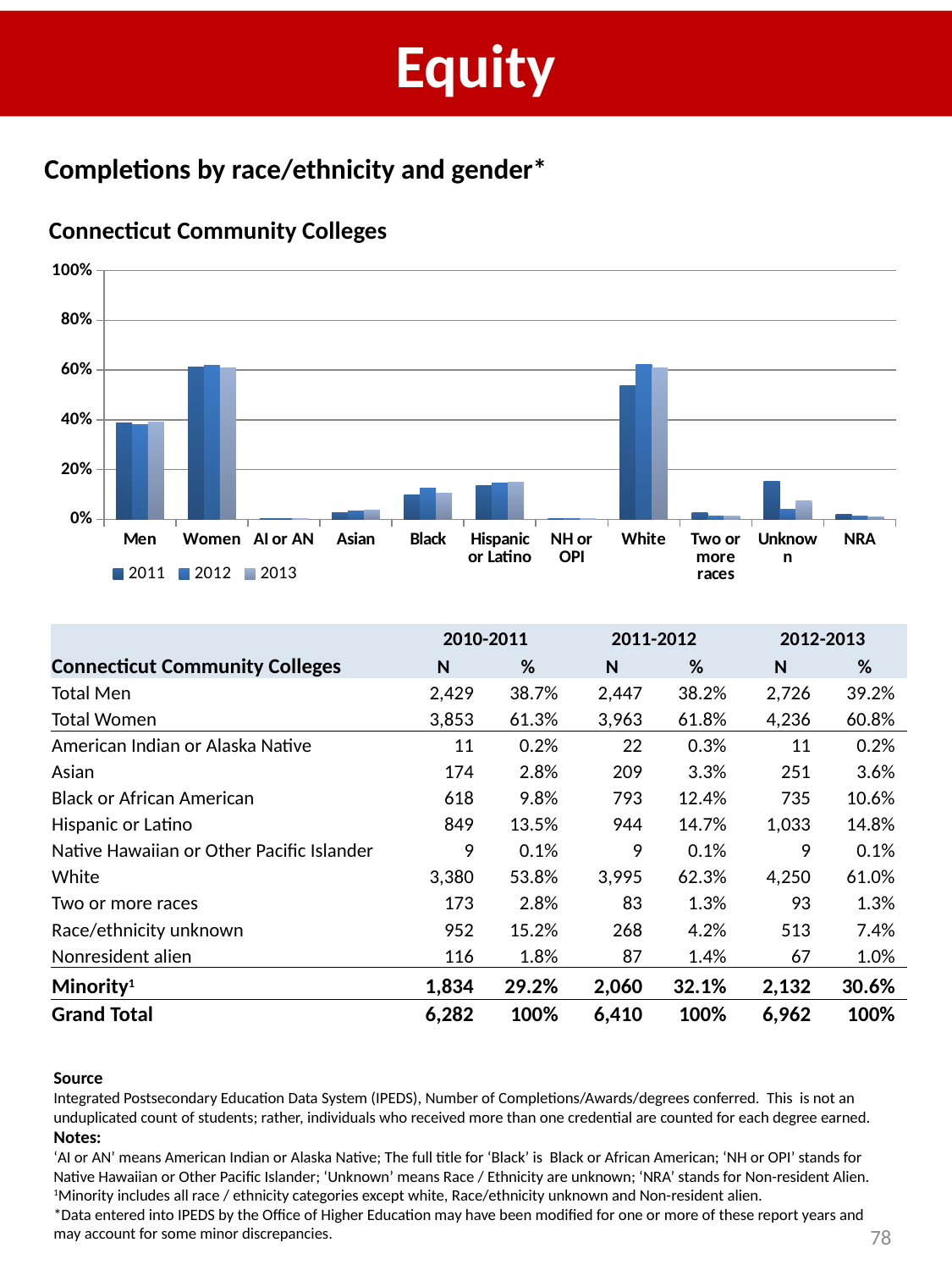
What are the three legend entries of the chart? 2011, 2012, 2013 Which category has the highest bar for 2011? Women Which is larger: the Unknown bar for 2011 or the Unknown bar for 2013? 2011 How many categories are shown along the x axis of the chart? 11 According to the table, what percentage of completions were White in 2011-2012? 62.3% Which is larger in 2012: the Black bar or the Hispanic or Latino bar? Hispanic or Latino Is the 2011 value for White greater or less than 60%? less How many series does the chart legend list? 3 Is the 2011 value for Unknown greater or less than 20%? less What kind of chart is shown on the slide? Bar chart Is the 2012 value for Women greater or less than 60%? greater Do the Hispanic or Latino bars rise or fall from 2011 to 2013? rise